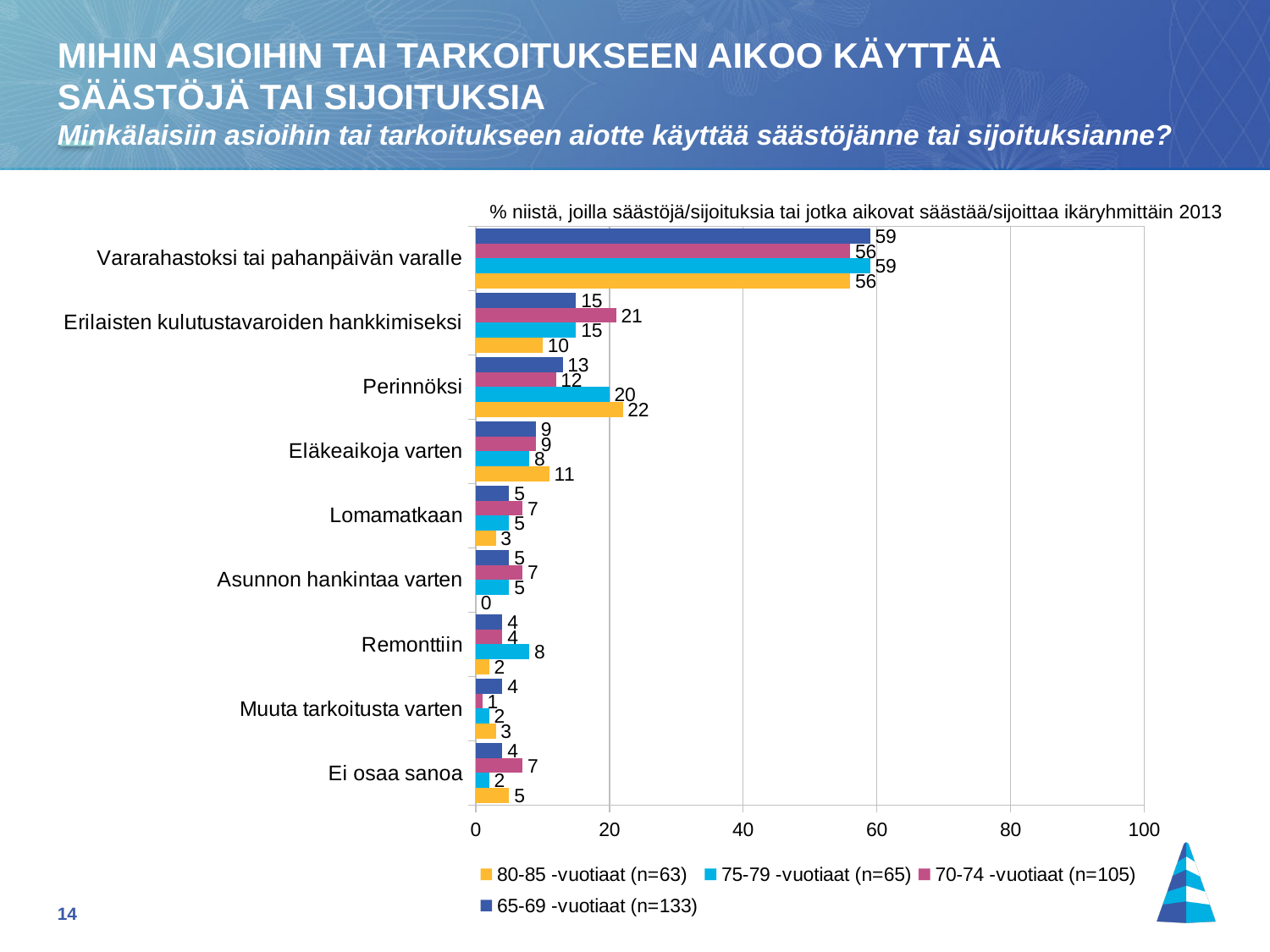
Is the value for 'Vararahastoksi tai pahanpäivän varalle' in the 70-74 -vuotiaat series greater or less than 40? greater Which category has the lowest value in the 80-85 -vuotiaat (n=63) series? Asunnon hankintaa varten What is the difference between the 80-85 -vuotiaat and 65-69 -vuotiaat values for 'Perinnöksi'? 9 What is the value for 'Erilaisten kulutustavaroiden hankkimiseksi' in the 70-74 -vuotiaat (n=105) series? 21 What kind of chart is shown on the slide? bar chart What is the value for 'Asunnon hankintaa varten' in the 80-85 -vuotiaat (n=63) series? 0 What is the value for 'Remonttiin' in the 75-79 -vuotiaat (n=65) series? 8 How many categories are shown on the chart? 9 Which category has the highest value in the 65-69 -vuotiaat (n=133) series? Vararahastoksi tai pahanpäivän varalle How many series does the legend list? 4 For 'Eläkeaikoja varten', which series has the larger value: 80-85 -vuotiaat (n=63) or 75-79 -vuotiaat (n=65)? 80-85 -vuotiaat (n=63) What is the value for 'Perinnöksi' in the 80-85 -vuotiaat (n=63) series? 22